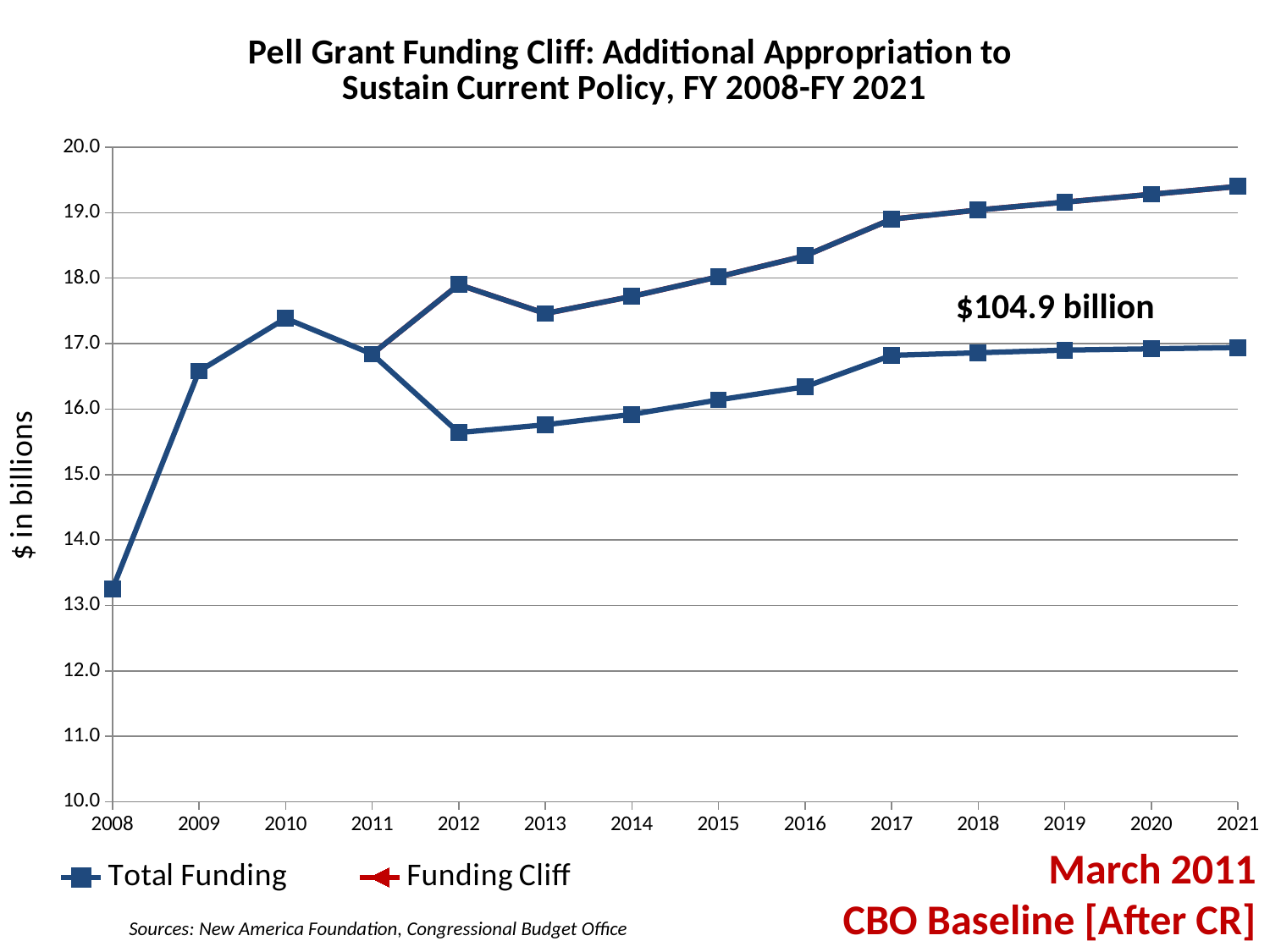
How many years are shown along the x axis? 14 Do the values rise or fall from 2008 to 2010? rise Is the value of the lower line for 2012 greater or less than 16.0? less Which year has the lowest plotted value on the chart? 2008 Is the value for 2008 greater or less than 14.0? less What kind of chart is shown on the slide? line chart Is the value of the upper line for 2021 greater or less than 19.0? greater What dollar amount is annotated on the chart? $104.9 billion What is the label on the y axis? $ in billions How many series does the legend list? 2